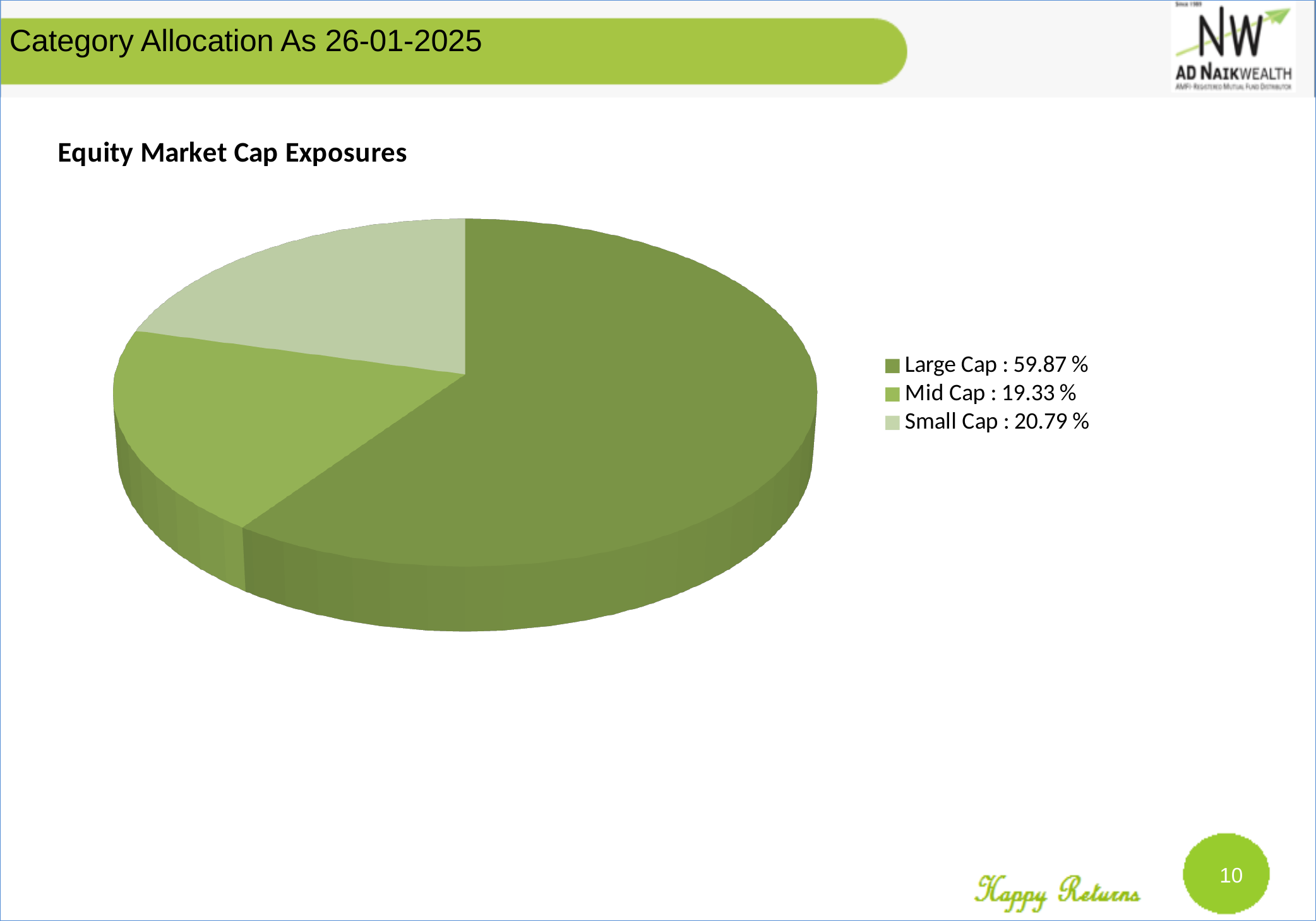
Which category has the smallest share of the pie? Mid Cap What is the difference between the Small Cap and Mid Cap shares? 1.46 % What is the difference between the Large Cap and Mid Cap shares? 40.54 % Which category has the largest share of the pie? Large Cap Which category is shown in the lightest green colour in the legend? Small Cap What is the value shown for Small Cap? 20.79 % What kind of chart is shown on the slide? Pie chart How many categories are shown in the pie chart? 3 Which is larger, the Small Cap share or the Mid Cap share? Small Cap What is the title of the chart? Equity Market Cap Exposures What share of the pie does Large Cap represent? 59.87 % What is the value shown for Mid Cap? 19.33 %